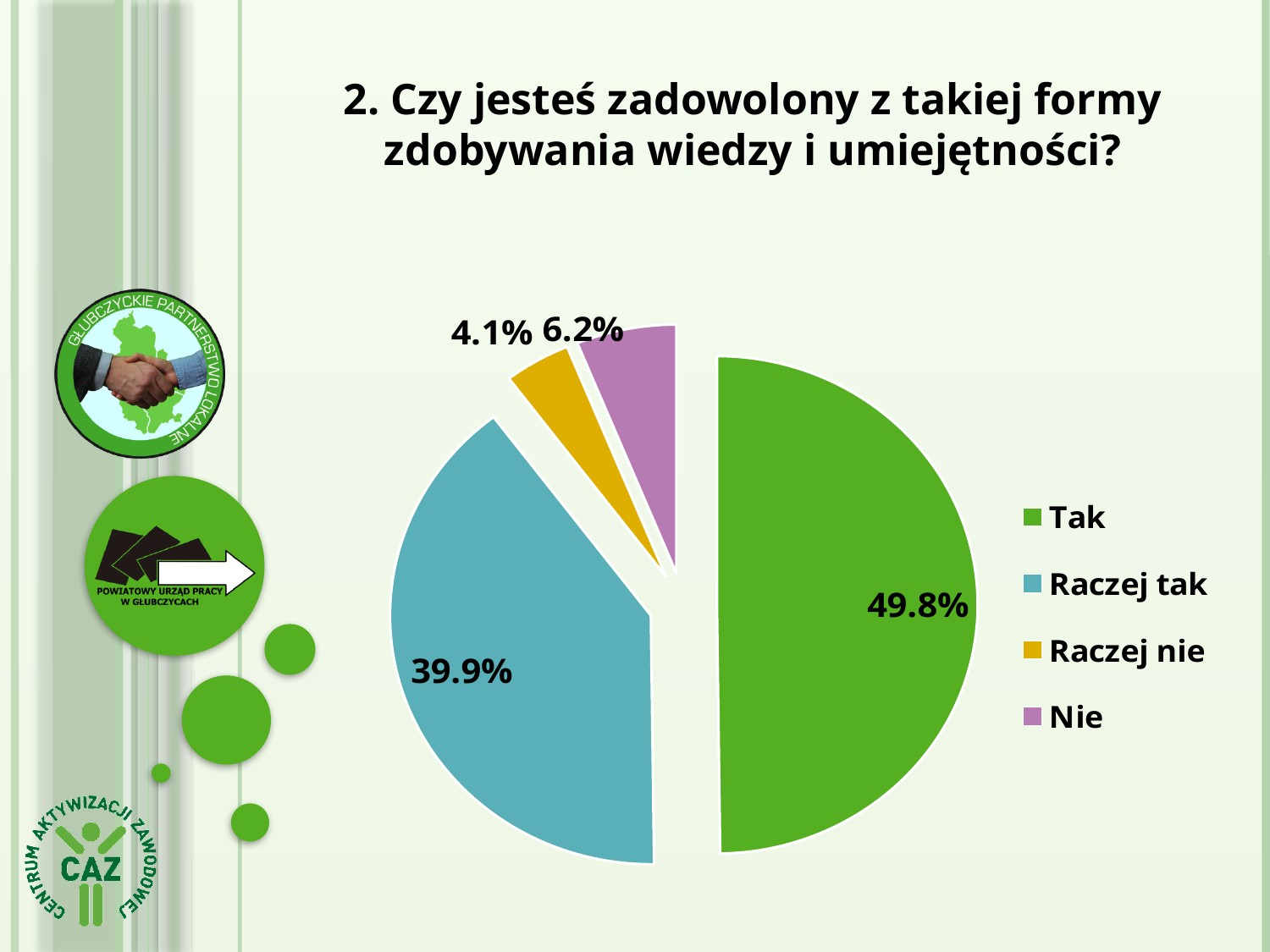
What percentage of respondents answered "Raczej nie"? 4.1% Which answer has the smallest share of the pie? Raczej nie Which answer has the largest share of the pie? Tak What percentage of respondents answered "Tak"? 49.8% What percentage of respondents answered "Nie"? 6.2% Which is larger, the share for "Nie" or the share for "Raczej nie"? Nie How many categories does the pie chart have? 4 What percentage of respondents answered "Raczej tak"? 39.9% What colour is the slice for "Raczej tak"? teal (blue-green) What is the difference in percentage points between "Tak" and "Raczej tak"? 9.9 What is the combined share of "Raczej nie" and "Nie"? 10.3% What kind of chart is shown on the slide? pie chart